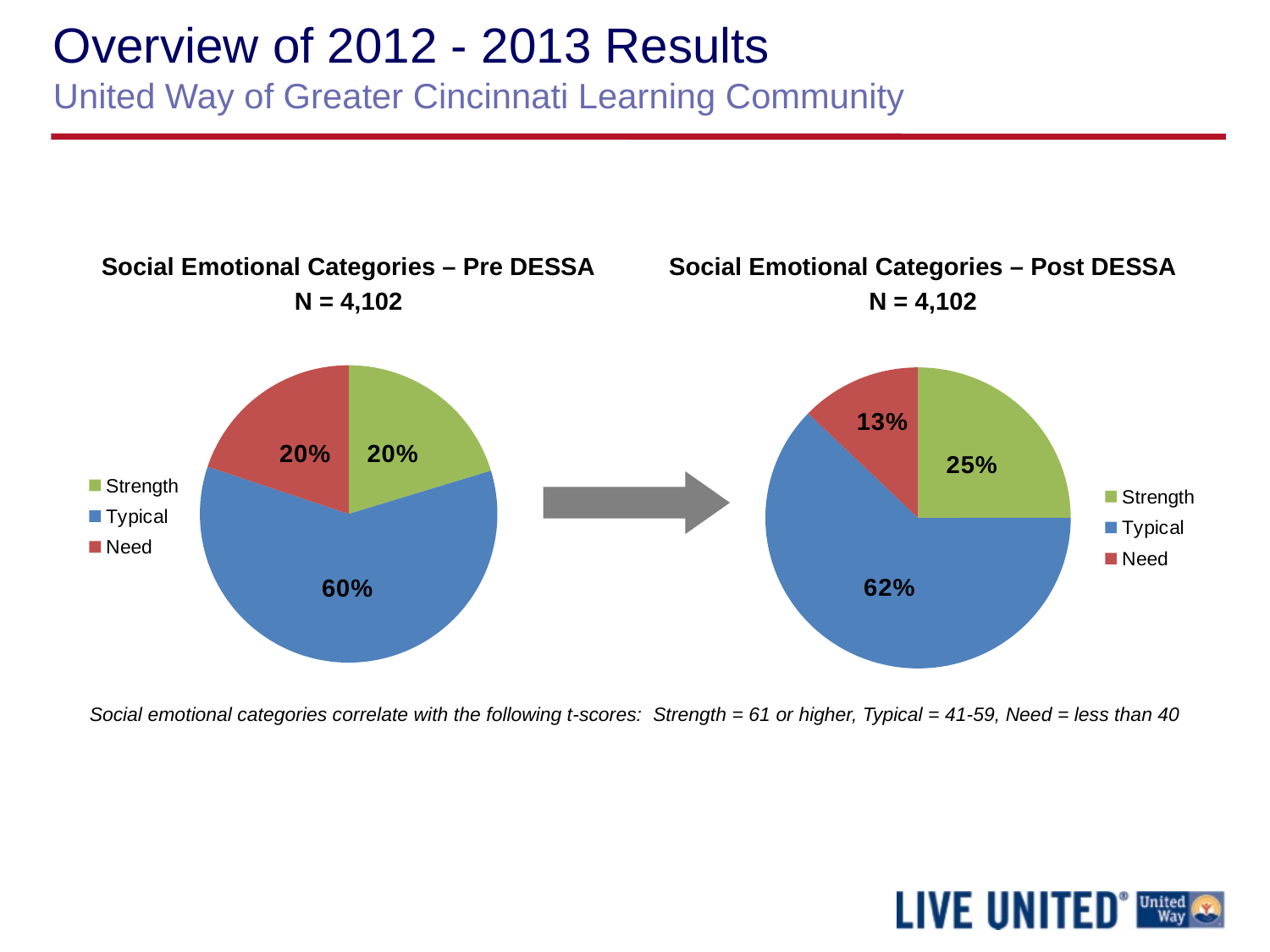
How many categories does the Pre DESSA pie chart show? 3 Is the Strength slice larger in the Pre DESSA chart or the Post DESSA chart? Post DESSA In the Post DESSA pie chart, what percentage is labelled for Need? 13% In the Pre DESSA pie chart, what percentage is labelled for Need? 20% What type of chart is used for the Social Emotional Categories – Post DESSA chart? Pie chart What is the difference between the Need percentage in the Pre DESSA chart and the Need percentage in the Post DESSA chart? 7% What is the N value shown under the Pre DESSA chart title? N = 4,102 In the Pre DESSA pie chart, what percentage is labelled for Typical? 60% In the Post DESSA pie chart, which category has the smallest slice? Need What is the difference between the Typical percentage in the Post DESSA chart and the Typical percentage in the Pre DESSA chart? 2% In the Post DESSA pie chart, what percentage is labelled for Strength? 25% In the Post DESSA pie chart, which category has the largest slice? Typical